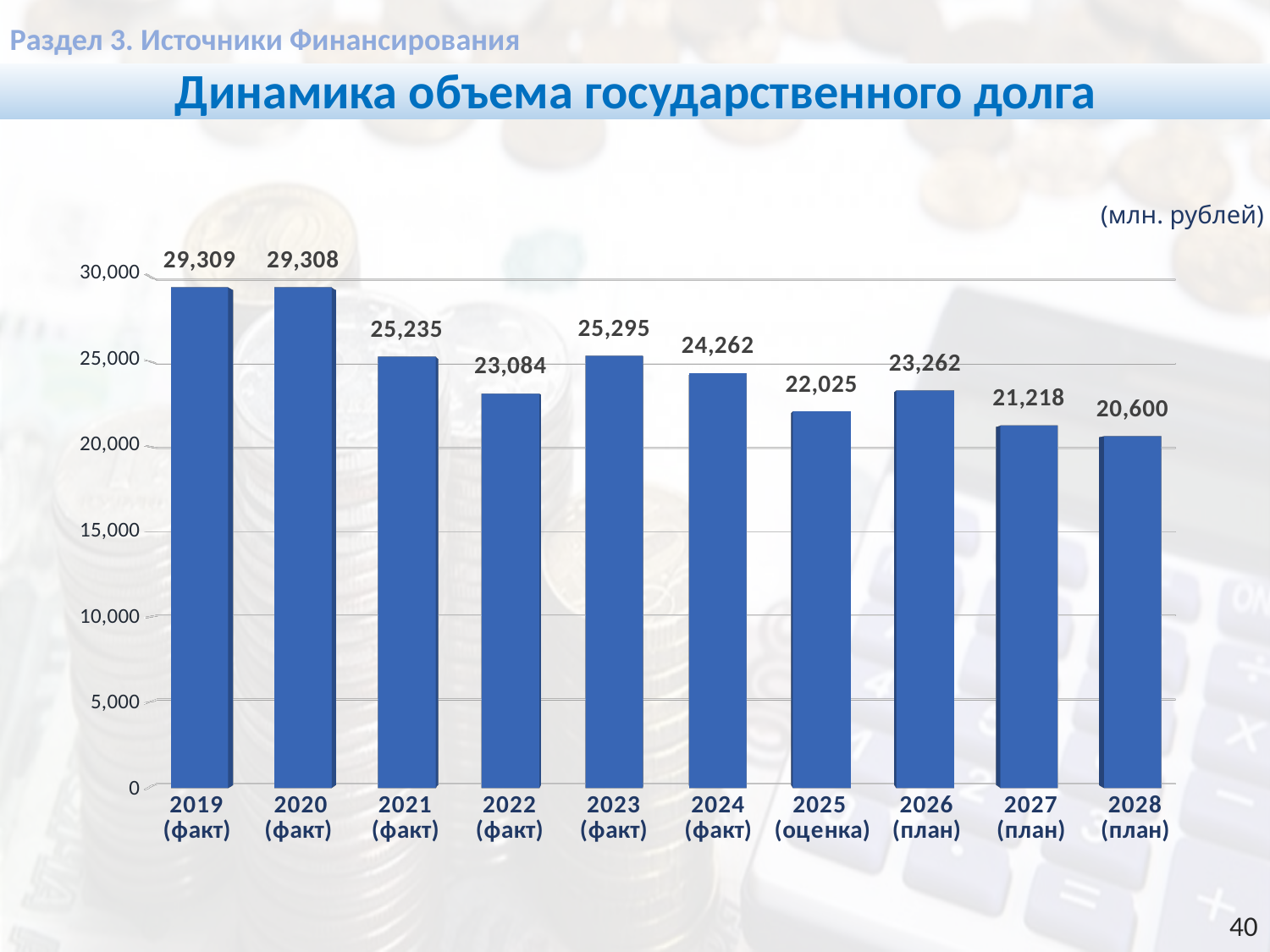
Do the values generally rise or fall from 2019 to 2028? fall What is the value for 2028 (план)? 20,600 What kind of chart is shown on the slide? bar chart What is the difference between the values for 2021 (факт) and 2022 (факт)? 2,151 What is the value for 2022 (факт)? 23,084 What is the value for 2025 (оценка)? 22,025 Which category has the lowest value? 2028 (план) Which is larger, the value for 2023 (факт) or the value for 2024 (факт)? 2023 (факт) What is the value for 2019 (факт)? 29,309 What is the difference between the values for 2019 (факт) and 2028 (план)? 8,709 Is the value for 2025 (оценка) greater or less than 25,000? less How many categories are shown on the x axis? 10